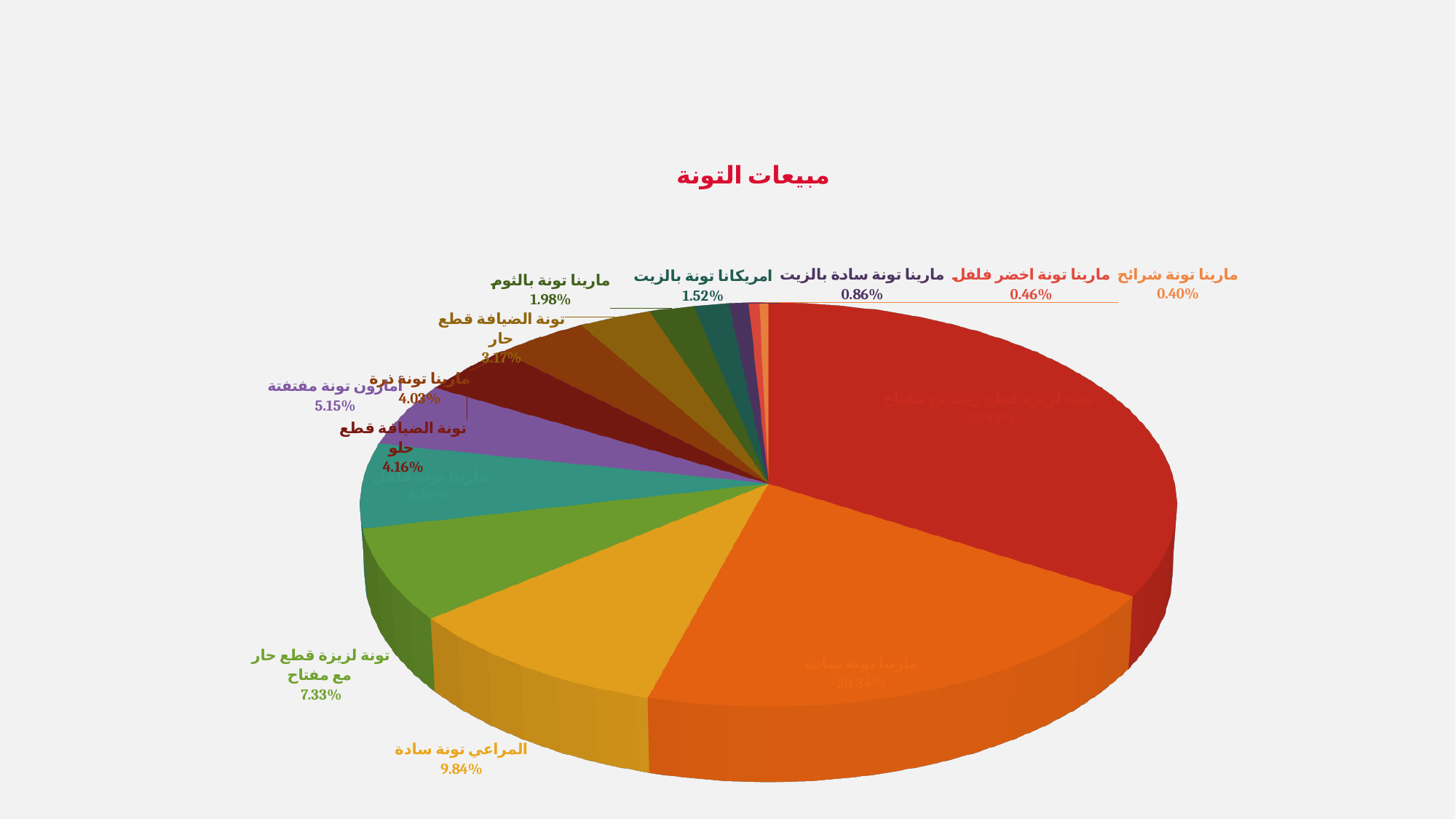
What is the difference in percentage points between مارينا تونة بالثوم and امريكانا تونة بالزيت? 0.46% What is the difference in percentage points between مارينا تونة سادة and المراعي تونة سادة? 10.50% What percentage is shown for مارينا تونة سادة? 20.34% Which has a larger share: المراعي تونة سادة or تونة لزيزة قطع حار مع مفتاح? المراعي تونة سادة What percentage is shown for مارينا تونة بالثوم? 1.98% What percentage is shown for تونة لزيزة قطع حار مع مفتاح? 7.33% Which category has the smallest share of the pie? مارينا تونة شرائح What percentage is shown for المراعي تونة سادة? 9.84% What percentage is shown for امريكانا تونة بالزيت? 1.52% What is the title of the chart? مبيعات التونة What kind of chart is shown on the slide? pie chart How many slices does the pie chart have? 14